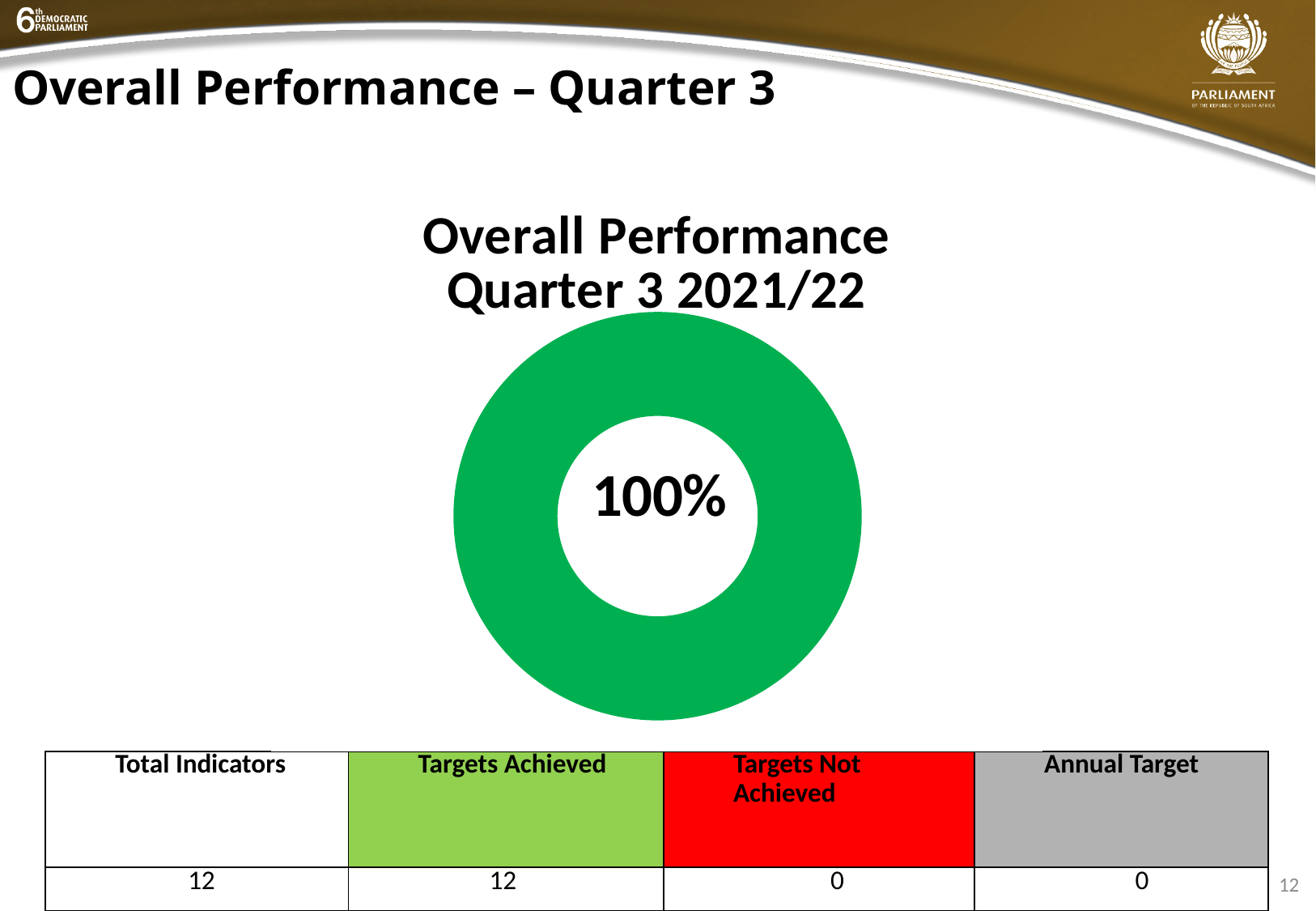
What colour is the single slice of the doughnut chart? Green What is the title of the chart? Overall Performance Quarter 3 2021/22 What percentage is printed in the centre of the doughnut chart? 100% Is the value shown in the doughnut chart greater or less than 50%? greater How many slices does the doughnut chart contain? 1 What kind of chart is shown on the slide? Doughnut chart What share of the doughnut chart does the green slice take up? 100%